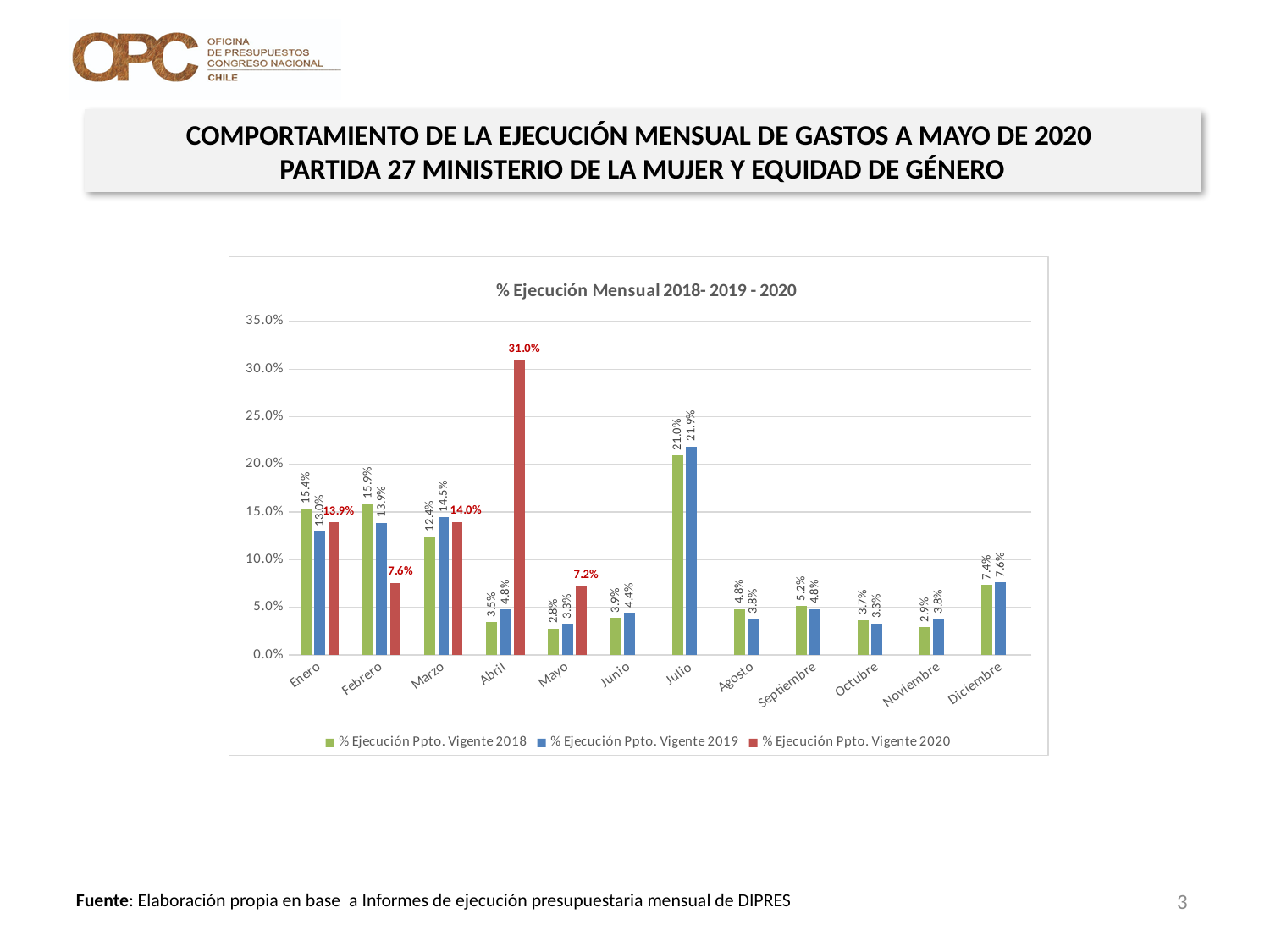
How many months are shown on the x axis? 12 How many series does the legend list? 3 In which month is the % Ejecución Ppto. Vigente 2018 series lowest? Mayo What is the value for % Ejecución Ppto. Vigente 2018 in Julio? 21.0% Which is larger in Febrero: the 2018 value or the 2020 value? 2018 value (15.9%) In which month is the % Ejecución Ppto. Vigente 2020 series highest? Abril What is the value for % Ejecución Ppto. Vigente 2020 in Mayo? 7.2% What is the title of the chart? % Ejecución Mensual 2018- 2019 - 2020 What is the value for % Ejecución Ppto. Vigente 2019 in Marzo? 14.5% What is the difference between the 2020 and 2019 values in Abril? 26.2% What is the value for % Ejecución Ppto. Vigente 2020 in Abril? 31.0% What kind of chart is shown on the slide? Bar chart